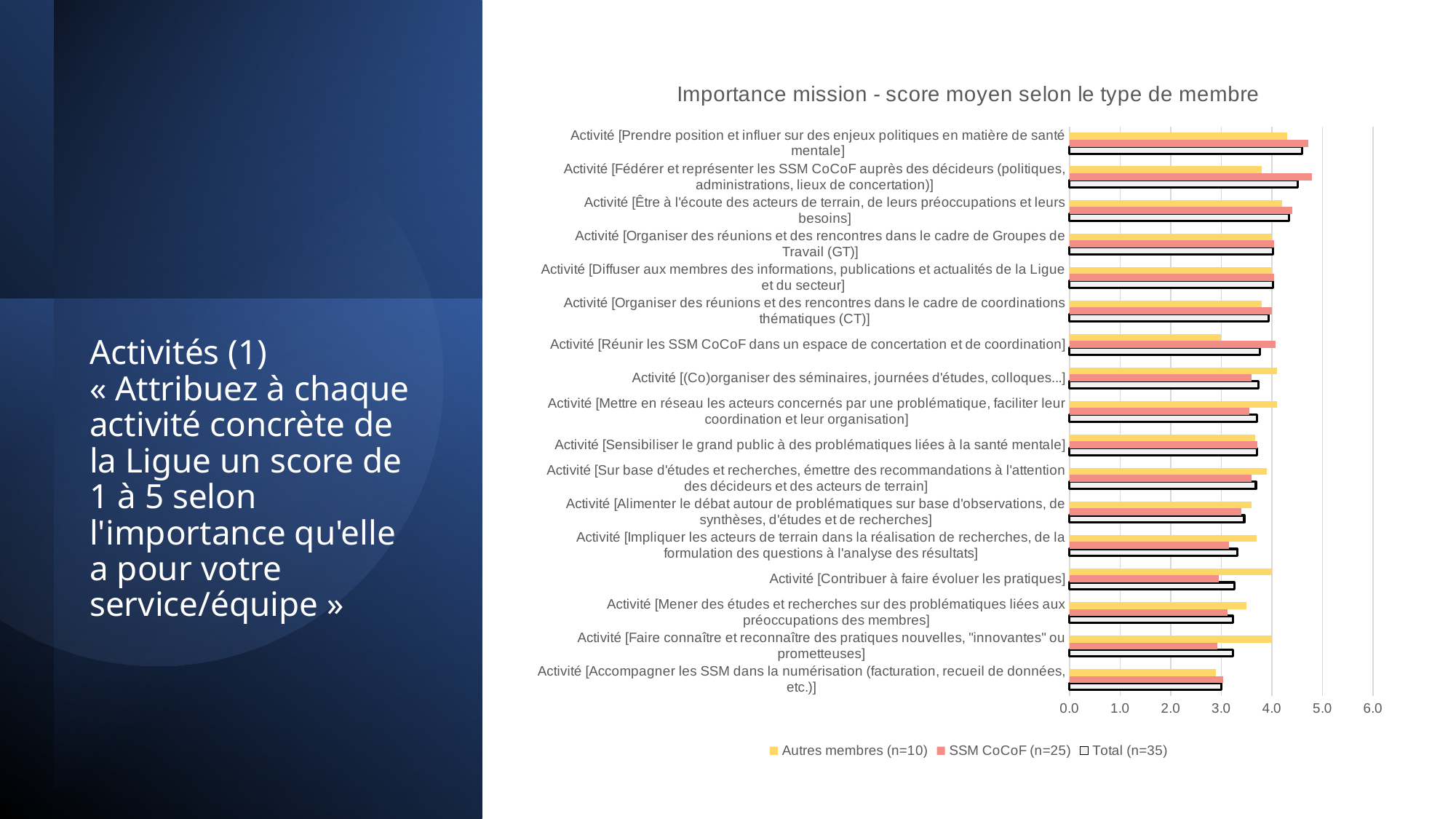
How many series does the legend list? 3 Is the Autres membres (n=10) value for 'Activité [Prendre position et influer sur des enjeux politiques en matière de santé mentale]' greater or less than 4.0? greater Which series is shown with the white bars outlined in black? Total (n=35) Which activity has the lowest Total (n=35) score? Activité [Accompagner les SSM dans la numérisation (facturation, recueil de données, etc.)] What kind of chart is shown on the slide? Bar chart For 'Activité [Réunir les SSM CoCoF dans un espace de concertation et de coordination]', which series has the larger value: Autres membres (n=10) or SSM CoCoF (n=25)? SSM CoCoF (n=25) Is the SSM CoCoF (n=25) value for 'Activité [Fédérer et représenter les SSM CoCoF auprès des décideurs (politiques, administrations, lieux de concertation)]' greater or less than 4.0? greater How many activity categories are plotted on the chart? 17 Is the Total (n=35) value for 'Activité [Impliquer les acteurs de terrain dans la réalisation de recherches, de la formulation des questions à l'analyse des résultats]' greater or less than 4.0? less What is the title of the chart? Importance mission - score moyen selon le type de membre For 'Activité [Contribuer à faire évoluer les pratiques]', which series has the larger value: Autres membres (n=10) or SSM CoCoF (n=25)? Autres membres (n=10)